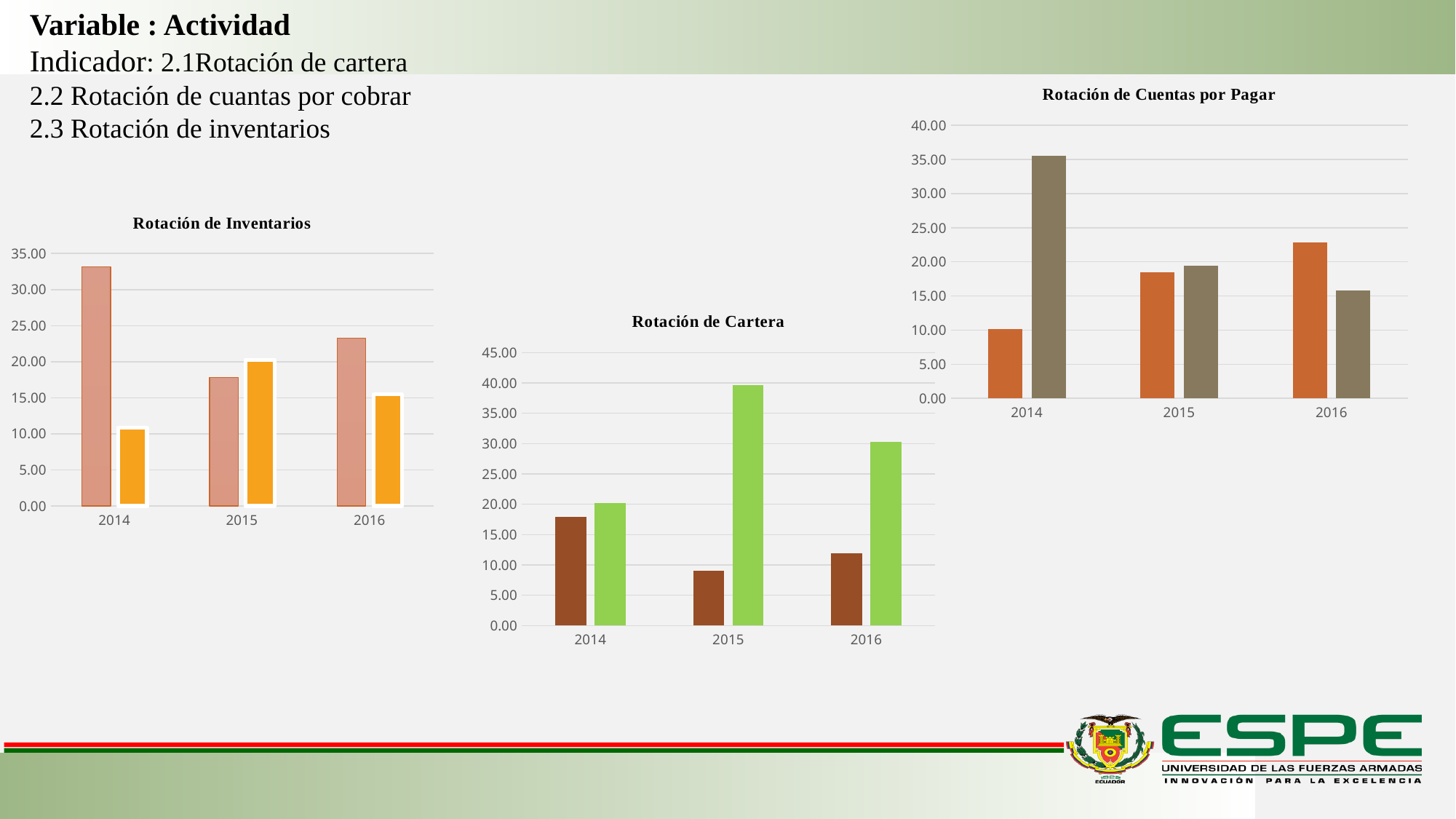
In the 'Rotación de Cartera' chart, which year has the tallest green bar? 2015 In the 'Rotación de Inventarios' chart, is the value of the yellow bar for 2014 greater or less than 15.00? less In the 'Rotación de Cuentas por Pagar' chart, do the orange bars rise or fall from 2014 to 2016? rise How many charts are shown on the slide? 3 In the 'Rotación de Cartera' chart, how many years are shown on the x axis? 3 What kind of chart is the 'Rotación de Inventarios' chart? bar chart In the 'Rotación de Cartera' chart, for 2015, which bar is larger, the brown one or the green one? the green one In the 'Rotación de Cartera' chart, is the green bar for 2015 greater or less than 35.00? greater In the 'Rotación de Inventarios' chart, is the value of the first (pink) bar for 2014 greater or less than 30.00? greater In the 'Rotación de Cartera' chart, in which year is the brown bar lowest? 2015 In the 'Rotación de Cuentas por Pagar' chart, which year contains the tallest bar? 2014